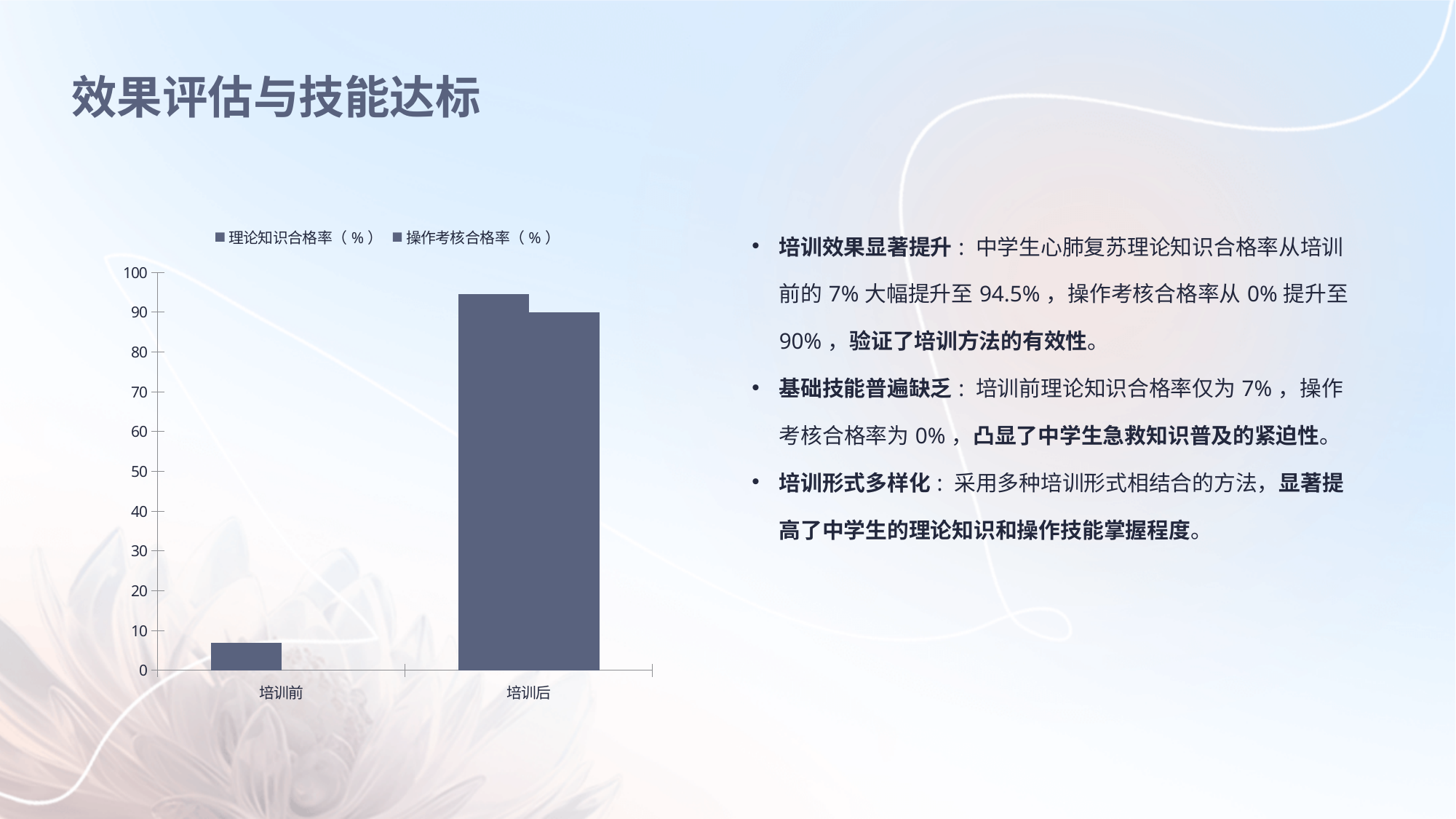
Does the value of 理论知识合格率（%）rise or fall from 培训前 to 培训后? rise For 培训后, which series has the larger value, 理论知识合格率（%）or 操作考核合格率（%）? 理论知识合格率（%） Which category has the highest value for 理论知识合格率（%）? 培训后 What kind of chart is shown on the slide? bar chart Is the value of 理论知识合格率（%）for 培训后 greater or less than 90? greater How many series does the chart legend list? 2 Is the value of 操作考核合格率（%）for 培训前 greater or less than 10? less What is the highest tick value shown on the y axis of the chart? 100 Is the value of 操作考核合格率（%）for 培训后 greater or less than 80? greater Which two series are listed in the chart legend? 理论知识合格率（%）and 操作考核合格率（%） How many categories are shown on the x axis of the chart? 2